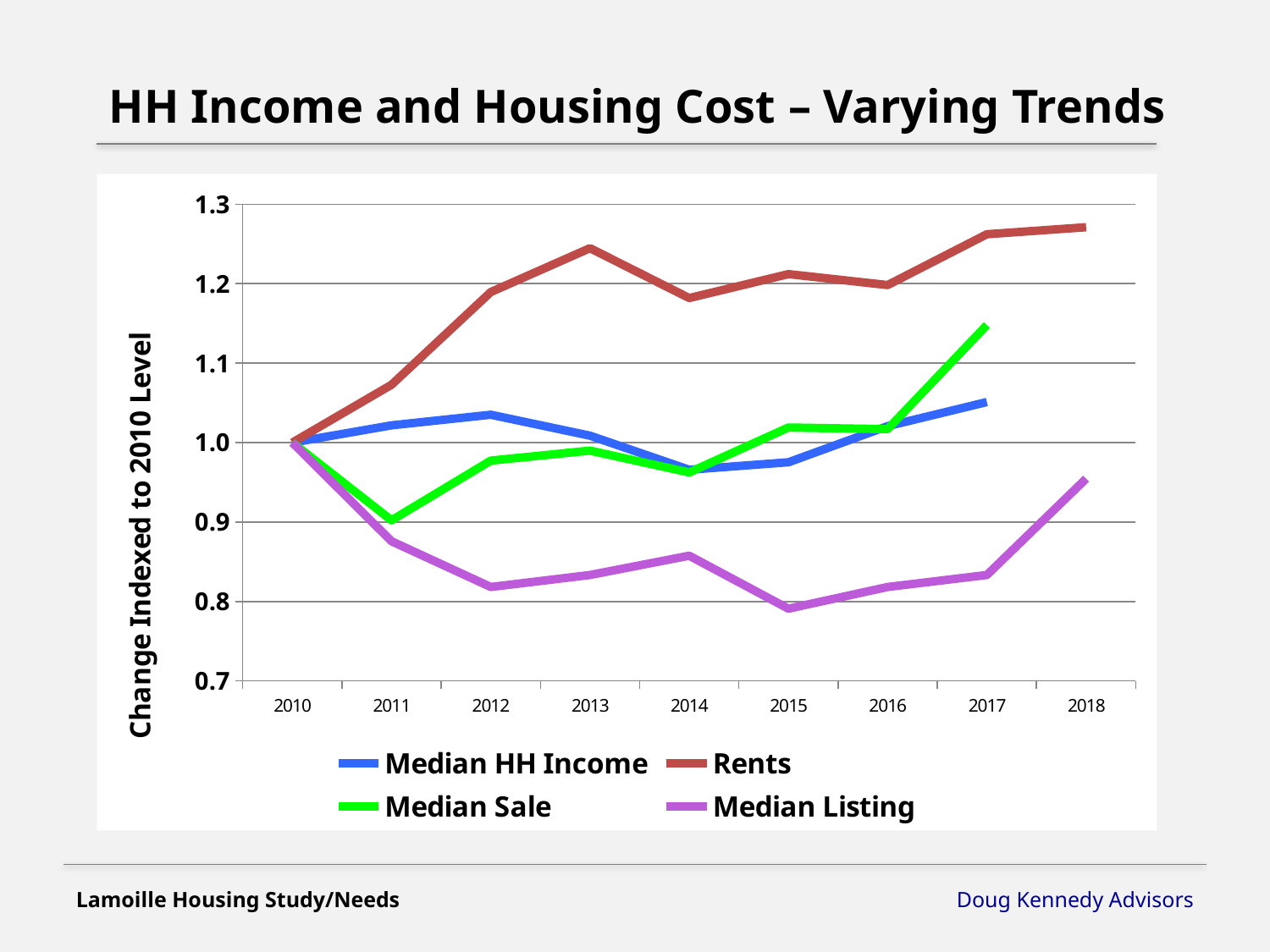
Does the Rents series rise or fall from 2010 to 2013? rise Which series has the lowest value in 2017? Median Listing In 2011, which is larger: Median HH Income or Median Sale? Median HH Income In which year does the Median Listing series reach its lowest value? 2015 Which series has the highest value in 2017? Rents What is the value of the Rents series in 2010? 1.0 Is the value for Rents in 2018 greater or less than 1.2? greater How many series does the legend list? 4 How many years are shown on the x axis? 9 What kind of chart is shown on the slide? line chart Is the value for Median Sale in 2017 greater or less than 1.1? greater